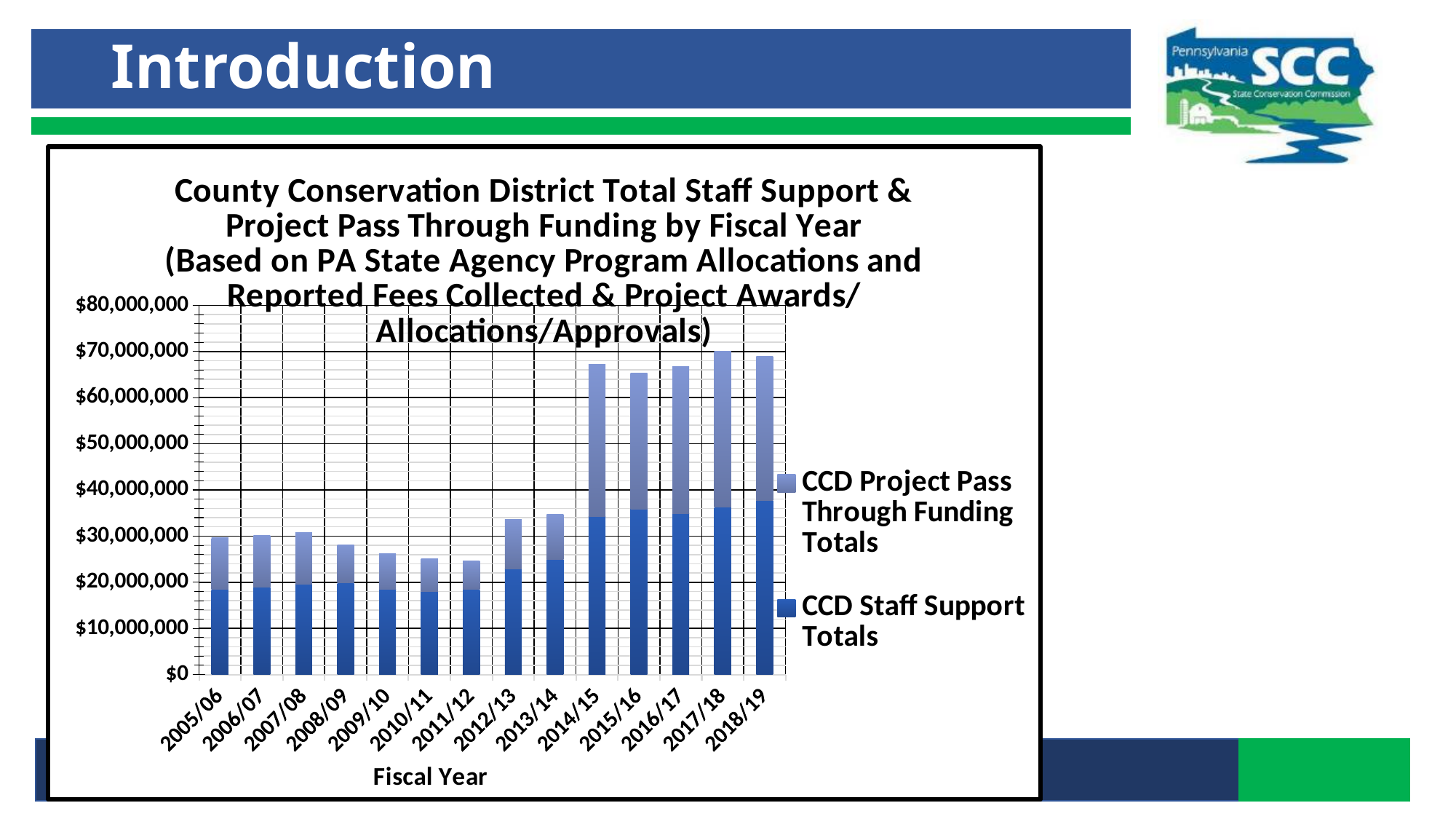
Is the total bar height for 2014/15 greater or less than $60,000,000? greater How many series does the chart's legend list? 2 Is the total bar height for 2017/18 greater or less than $50,000,000? greater What is the title of the x axis of the chart? Fiscal Year Do the total bar heights generally rise or fall from 2005/06 to 2018/19? rise Is the total bar height for 2011/12 greater or less than $30,000,000? less How many fiscal years are shown on the x axis of the chart? 14 Which fiscal year has a larger total bar, 2013/14 or 2014/15? 2014/15 Which fiscal year has a larger CCD Staff Support Totals value, 2010/11 or 2015/16? 2015/16 What kind of chart is shown on the slide? Stacked bar chart